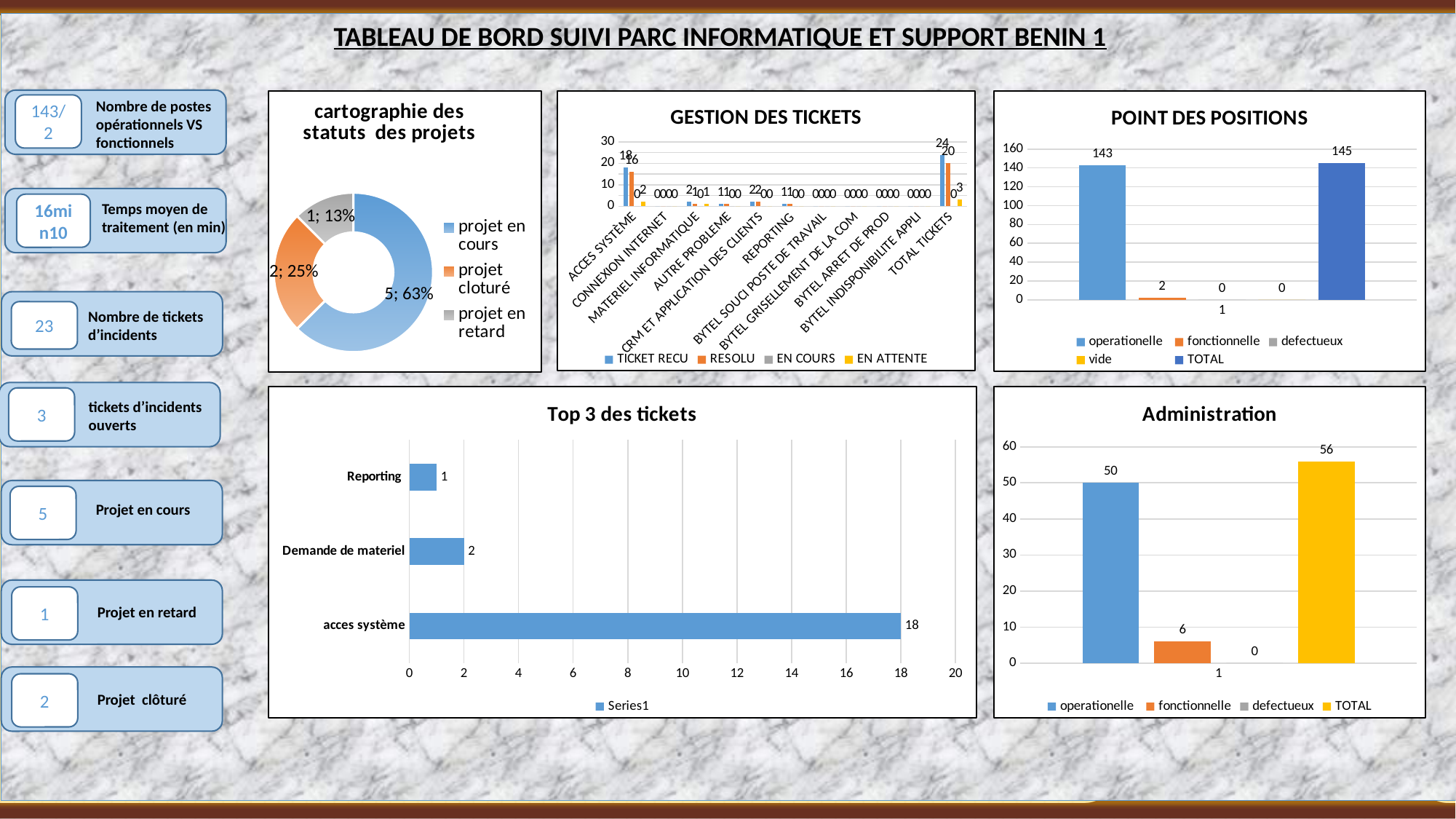
In the 'cartographie des statuts des projets' chart, what share does 'projet en cours' represent? 63% In the 'GESTION DES TICKETS' chart, how many series does the legend list? 4 In the 'cartographie des statuts des projets' chart, which category has the smallest slice? projet en retard In the 'POINT DES POSITIONS' chart, how many series does the legend list? 5 In the 'Top 3 des tickets' chart, what is the value for acces système? 18 In the 'Administration' chart, what is the difference between operationelle and fonctionnelle? 44 In the 'POINT DES POSITIONS' chart, what is the value for TOTAL? 145 In the 'Top 3 des tickets' chart, what is the difference between acces système and Demande de materiel? 16 In the 'GESTION DES TICKETS' chart, what is the TICKET RECU value for TOTAL TICKETS? 24 In the 'Administration' chart, what is the value for fonctionnelle? 6 What kind of chart is 'cartographie des statuts des projets'? Donut chart In the 'Top 3 des tickets' chart, how many categories are shown? 3